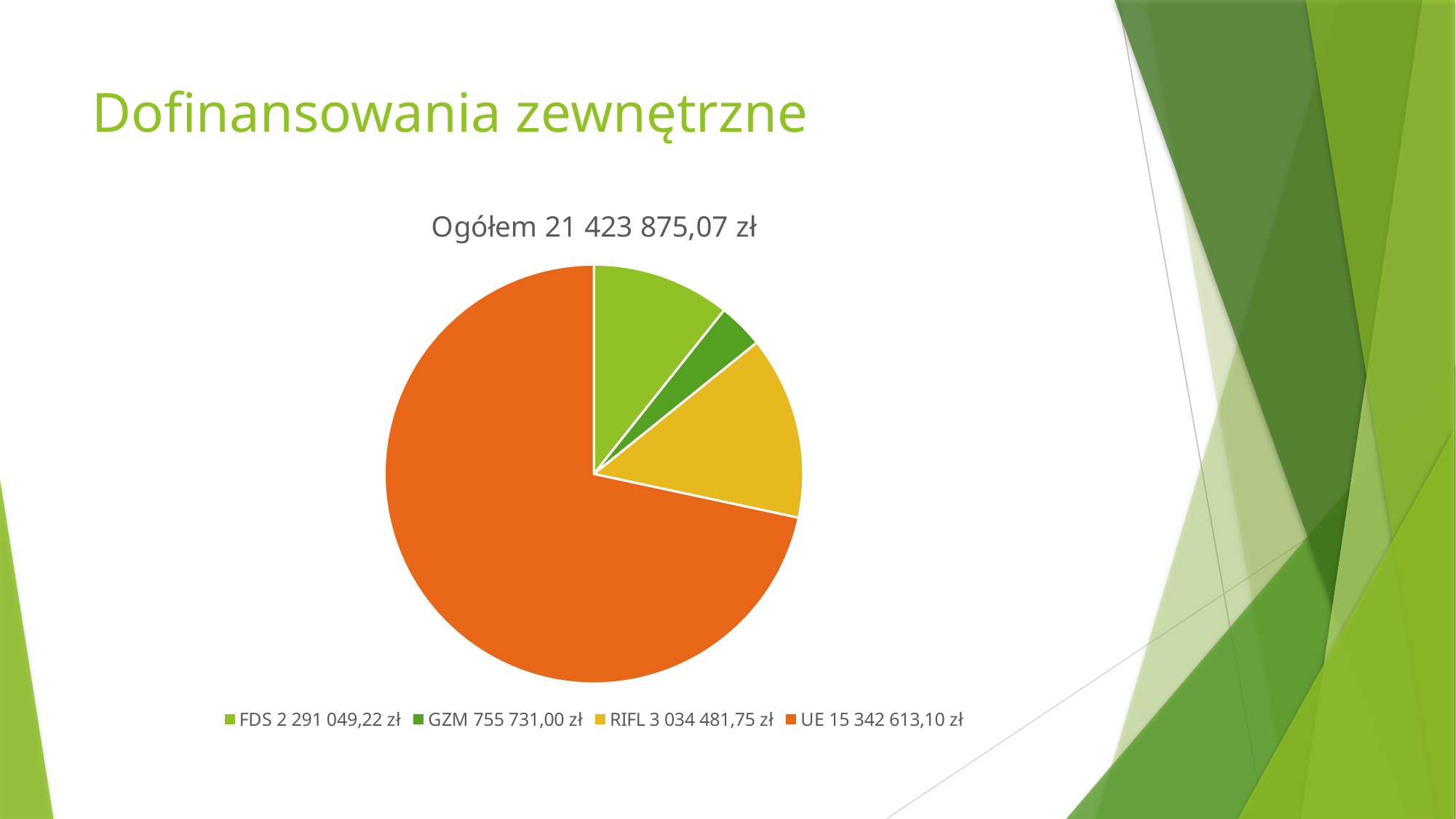
What is the title of the chart? Ogółem 21 423 875,07 zł What is the value for GZM? 755 731,00 zł What kind of chart is shown on the slide? pie chart What colour is the UE slice of the pie? orange What is the value for RIFL? 3 034 481,75 zł Which category has the largest slice of the pie? UE How many categories does the pie chart have? 4 What is the value for UE? 15 342 613,10 zł Which category has the smallest slice of the pie? GZM What is the difference between the values for RIFL and FDS? 743 432,53 zł Which is larger, the value for FDS or the value for RIFL? RIFL What is the value for FDS? 2 291 049,22 zł